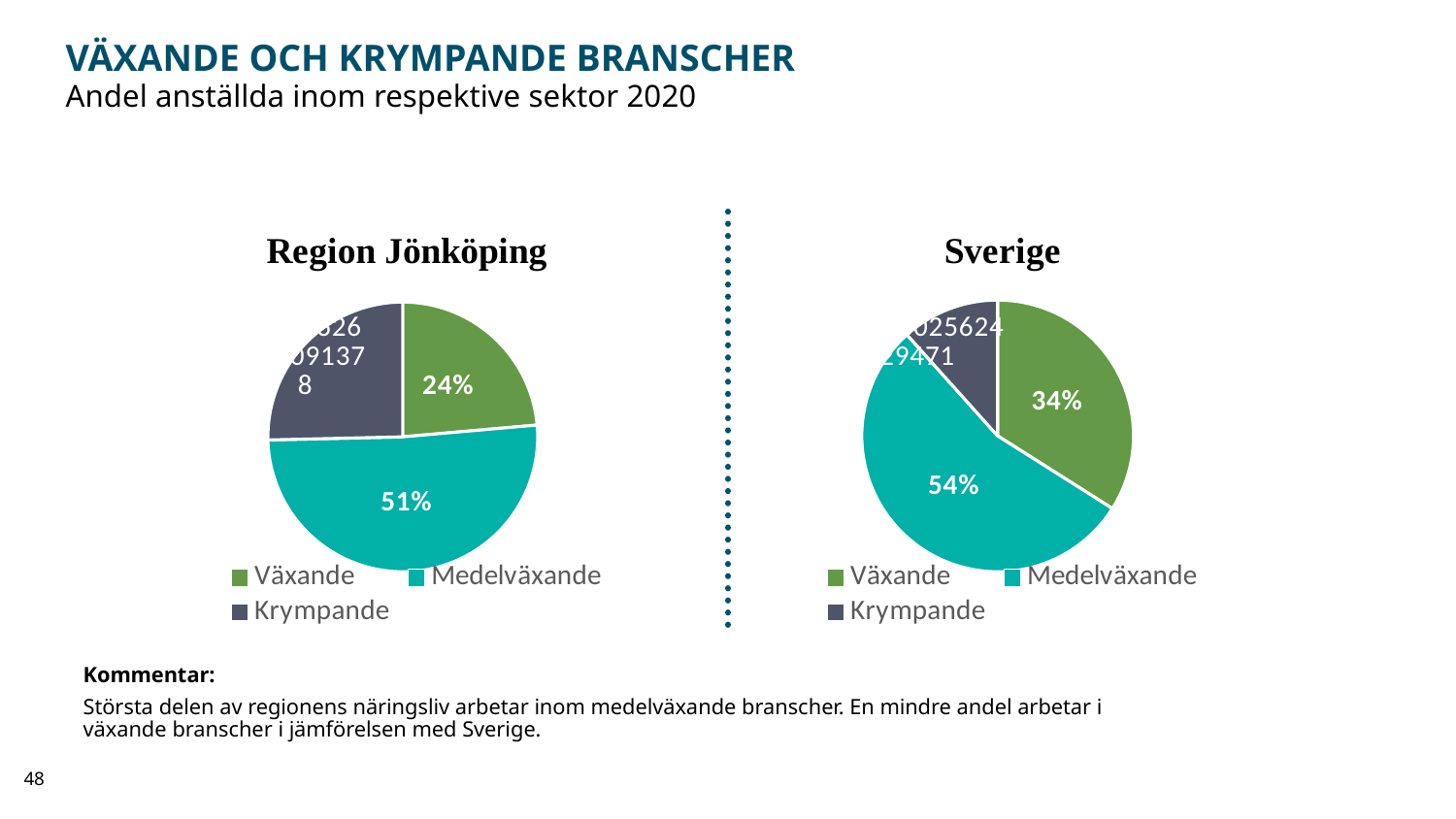
How many categories does the legend of the Sverige chart list? 3 What is the title of the chart on the right side of the slide? Sverige In the Sverige pie chart, how many percentage points larger is Medelväxande than Växande? 20 percentage points In the Region Jönköping pie chart, what share is shown for Medelväxande? 51% In the Sverige pie chart, which category has the smallest slice? Krympande In the Region Jönköping pie chart, how many percentage points larger is Medelväxande than Växande? 27 percentage points What type of chart is used for Region Jönköping? Pie chart Is the Växande share larger in the Region Jönköping chart or in the Sverige chart? Sverige In the Region Jönköping pie chart, what share is shown for Växande? 24% In the Region Jönköping pie chart, which category has the largest slice? Medelväxande In the Sverige pie chart, what share is shown for Växande? 34% In the Sverige pie chart, what share is shown for Medelväxande? 54%